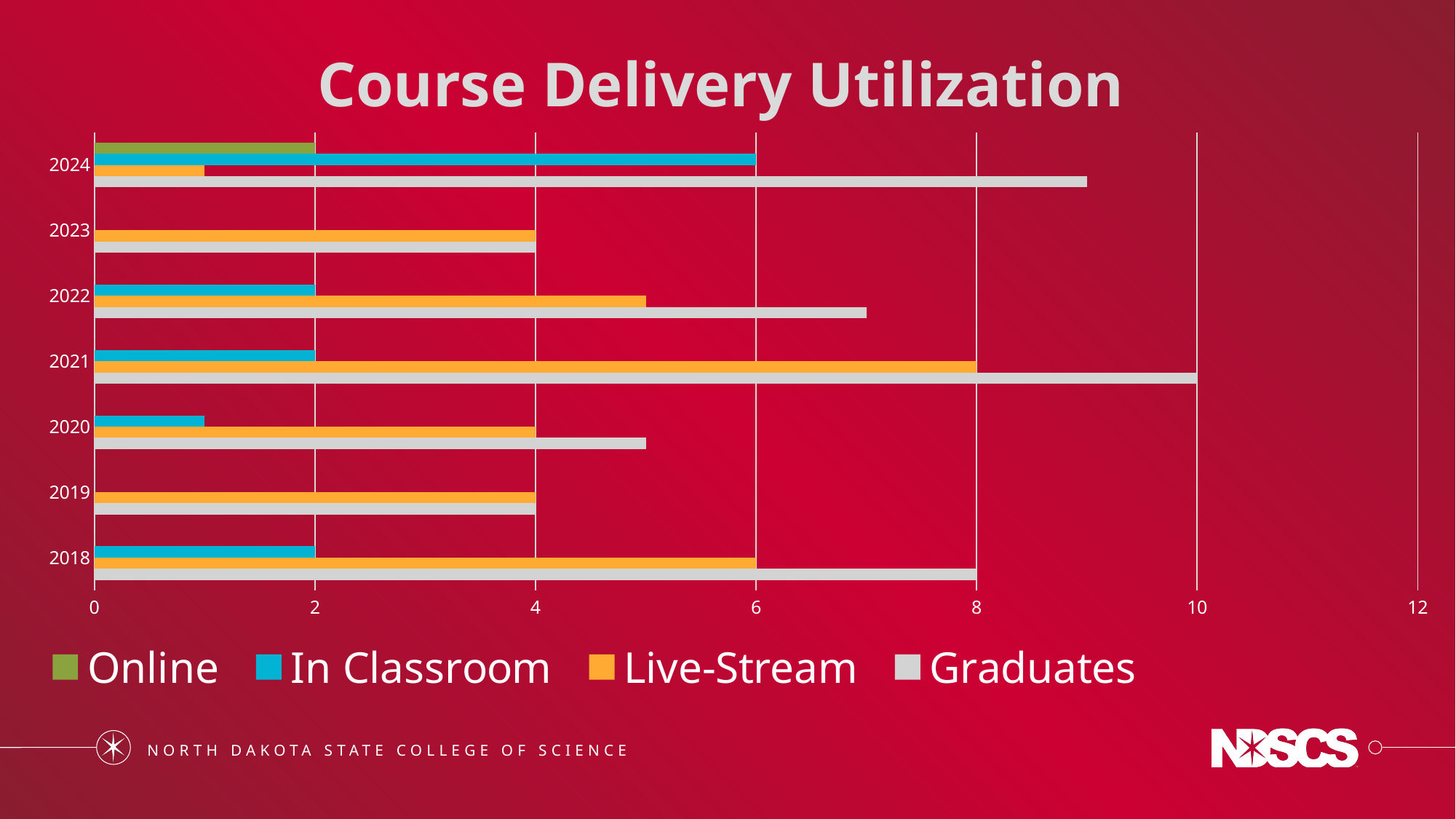
How many series does the legend list? 4 What is the difference between the Graduates value for 2021 and the Graduates value for 2018? 2 What is the Graduates value for 2021? 10 What type of chart is shown on the slide? Bar chart Which year has the larger Graduates value, 2021 or 2018? 2021 In which year is the Graduates value highest? 2021 What is the title of the chart? Course Delivery Utilization What is the In Classroom value for 2024? 6 How many years are shown on the chart? 7 What is the Live-Stream value for 2018? 6 In which year is the Live-Stream value highest? 2021 Is the Graduates value for 2024 greater or less than 8? greater